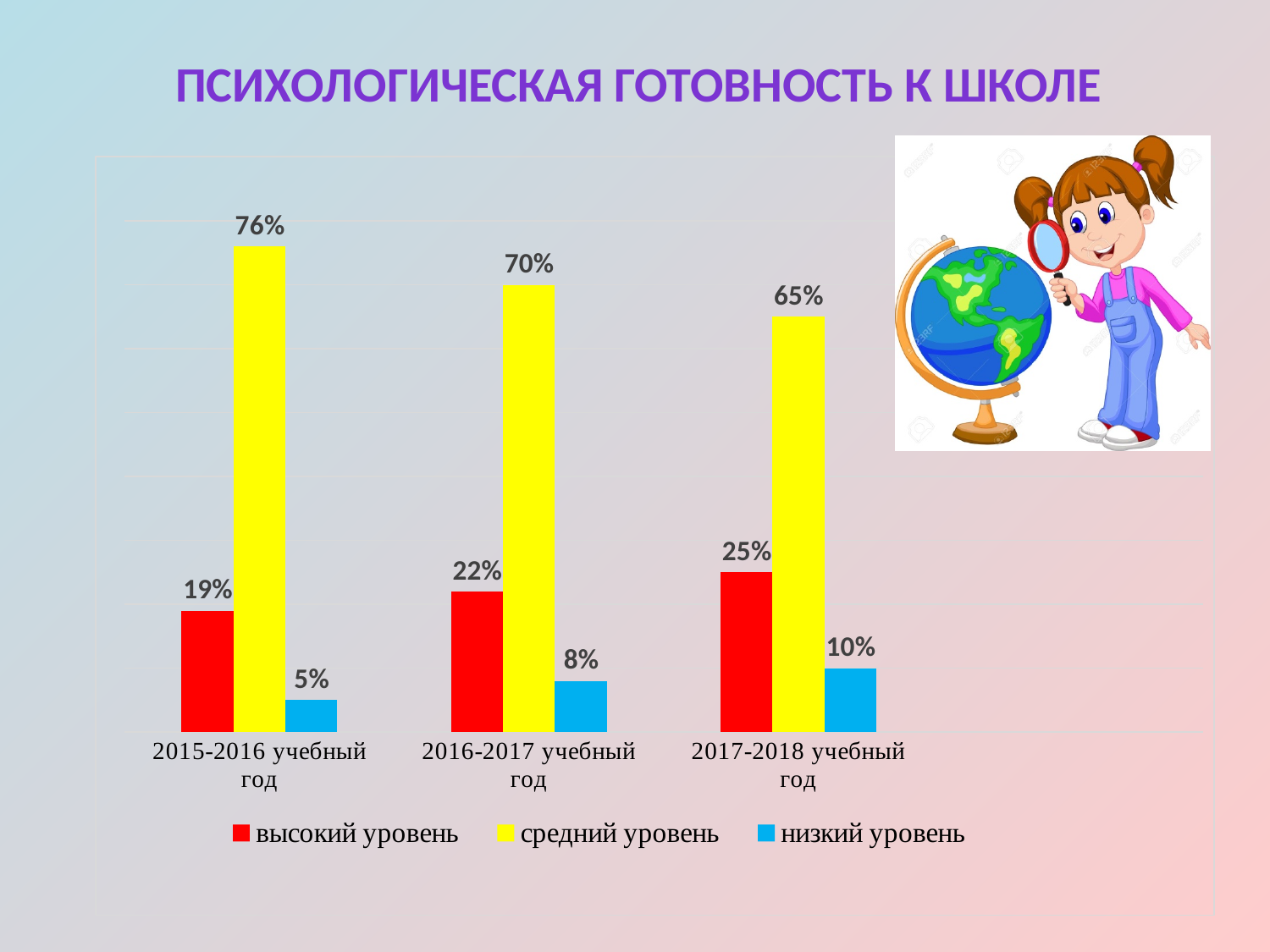
What colour represents низкий уровень in the chart? blue In which school year is the низкий уровень value lowest? 2015-2016 учебный год What is the value for высокий уровень in 2015-2016 учебный год? 19% What kind of chart is shown on the slide? bar chart How many school years are shown on the x axis? 3 Does the высокий уровень value rise or fall from 2015-2016 to 2017-2018? rise What is the value for средний уровень in 2016-2017 учебный год? 70% How many series does the legend list? 3 What is the value for низкий уровень in 2017-2018 учебный год? 10% What is the difference between the средний уровень values for 2015-2016 учебный год and 2017-2018 учебный год? 11% Which is larger: высокий уровень in 2016-2017 учебный год or высокий уровень in 2017-2018 учебный год? 2017-2018 учебный год In which school year is the средний уровень value highest? 2015-2016 учебный год